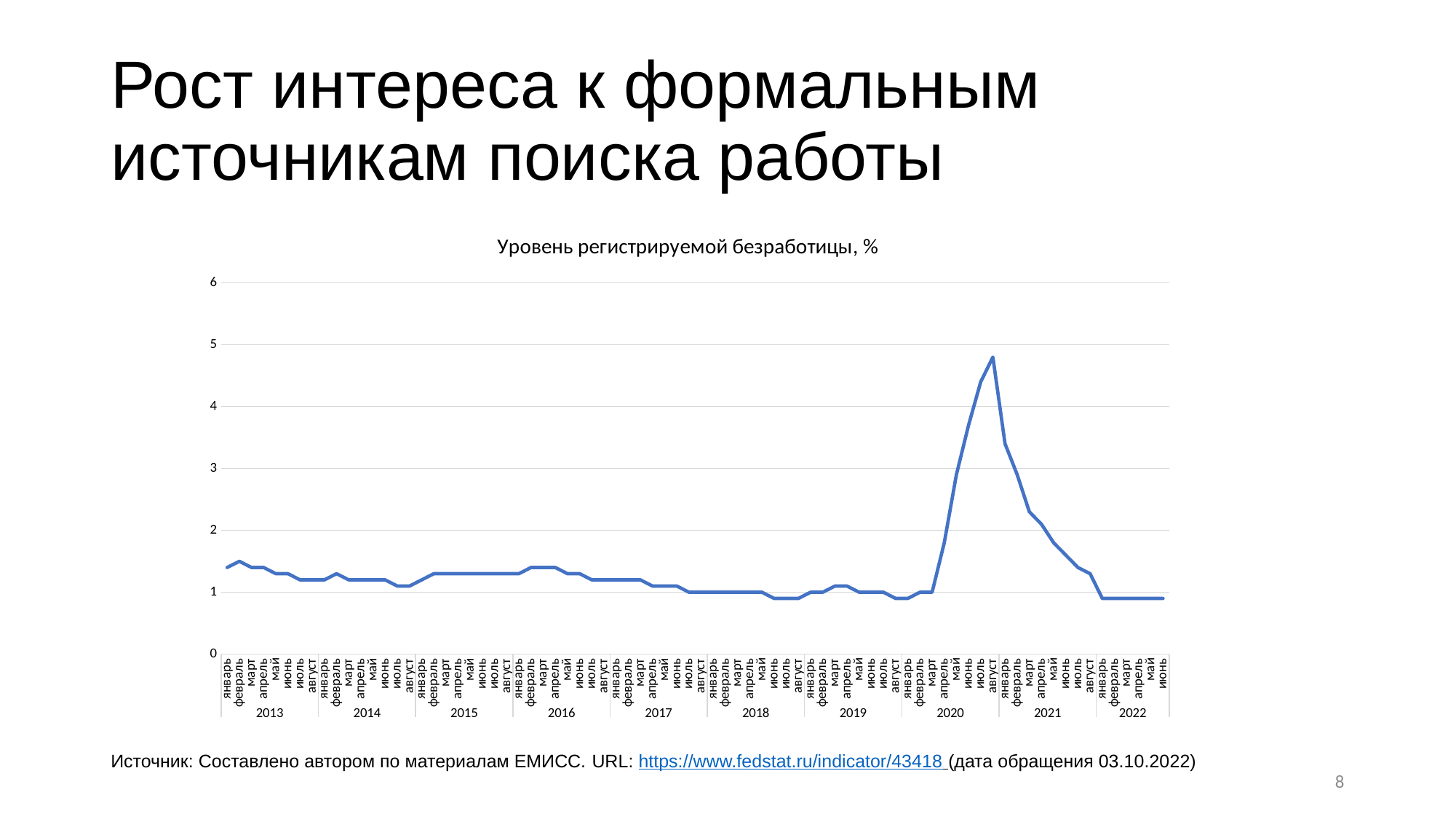
What is the highest value shown on the y axis? 6 What kind of chart is shown on the slide? line chart Is the value for январь 2021 greater or less than 3? greater Is the value for январь 2020 greater or less than 2? less How many years are labelled along the x axis? 10 Is the value for июнь 2022 greater or less than 1? less In which month and year does the registered unemployment rate reach its highest point? август 2020 What is the title of the chart? Уровень регистрируемой безработицы, % Which is larger, the value for август 2020 or the value for август 2019? август 2020 Does the registered unemployment rate rise or fall from август 2020 to июнь 2022? fall